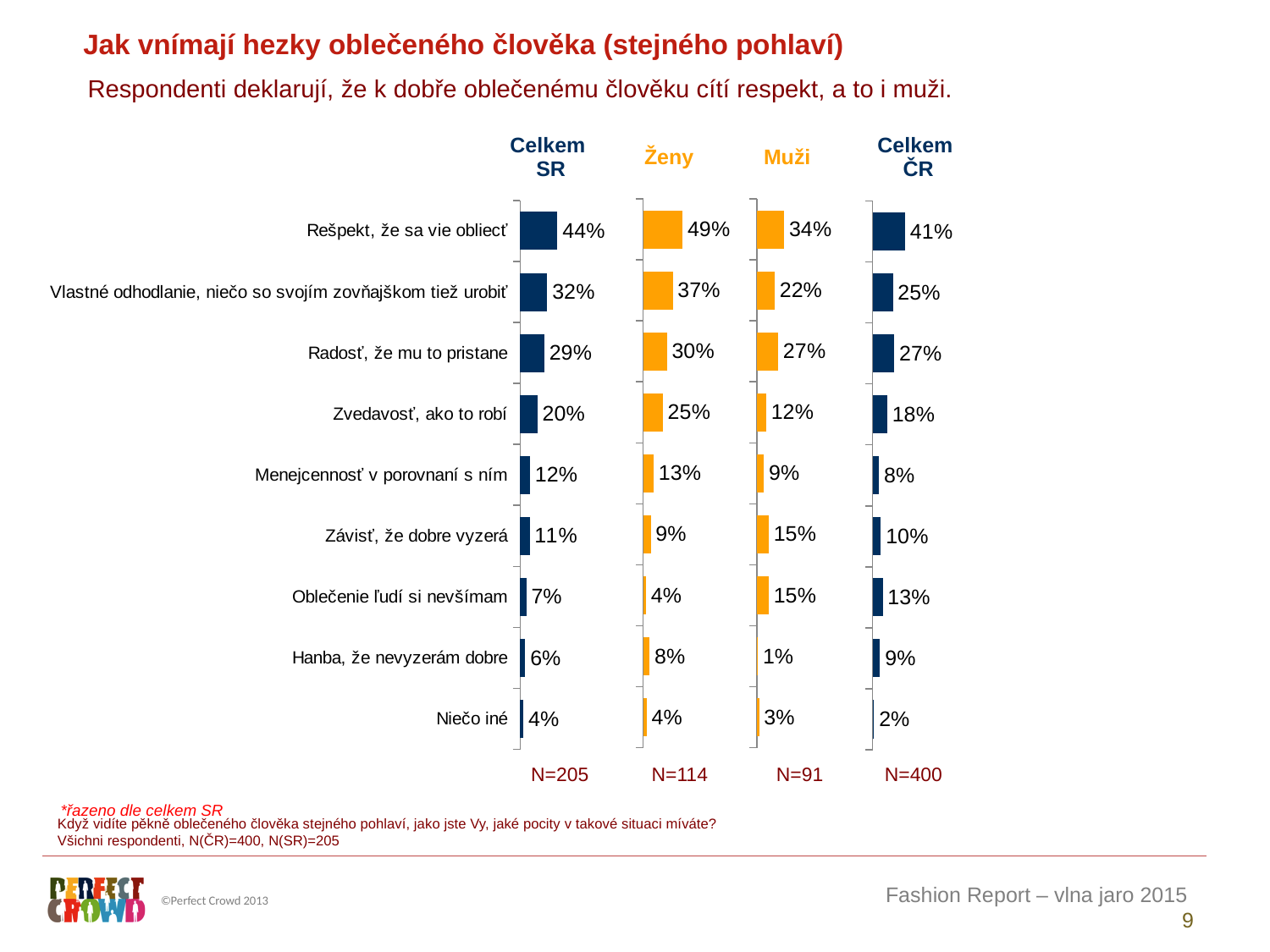
How many categories are shown in the Celkem SR chart? 9 In the Celkem ČR chart, what is the value for "Oblečenie ľudí si nevšímam"? 13% In the Celkem ČR chart, which category has the lowest value? Niečo iné What kind of chart is used on this slide? Bar chart What is the difference between the Ženy and Muži values for "Rešpekt, že sa vie obliecť"? 15% In the Celkem SR chart, what is the value for "Rešpekt, že sa vie obliecť"? 44% In the Ženy chart, what is the value for "Zvedavosť, ako to robí"? 25% For "Závisť, že dobre vyzerá", which is larger: the Ženy value or the Muži value? Muži What is the difference between the Celkem SR and Celkem ČR values for "Vlastné odhodlanie, niečo so svojím zovňajškom tiež urobiť"? 7% In the Muži chart, what is the value for "Hanba, že nevyzerám dobre"? 1% In the Muži chart, which category has the highest value? Rešpekt, že sa vie obliecť What is the sample size (N) shown under the Muži chart? N=91